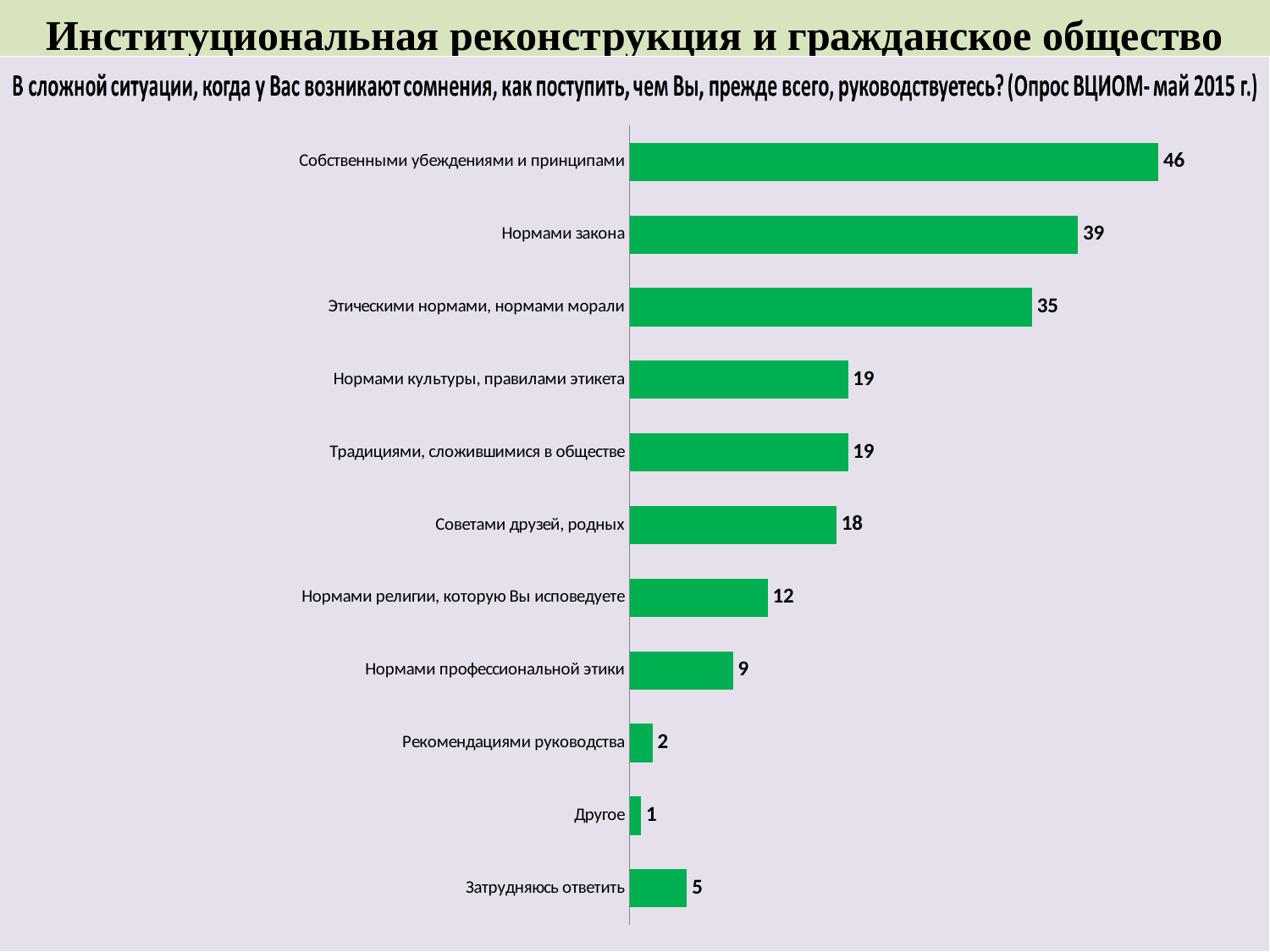
What is the difference between the values for "Этическими нормами, нормами морали" and "Нормами профессиональной этики"? 26 How many categories are shown in the chart? 11 What kind of chart is shown on the slide? Bar chart Which category has the highest value? Собственными убеждениями и принципами Which is larger: the value for "Советами друзей, родных" or the value for "Нормами религии, которую Вы исповедуете"? Советами друзей, родных Which category has the lowest value? Другое What colour are the bars in the chart? Green What is the value for "Собственными убеждениями и принципами"? 46 What is the value for "Нормами религии, которую Вы исповедуете"? 12 What is the value for "Затрудняюсь ответить"? 5 What is the difference between the values for "Собственными убеждениями и принципами" and "Нормами закона"? 7 What is the value for "Нормами закона"? 39